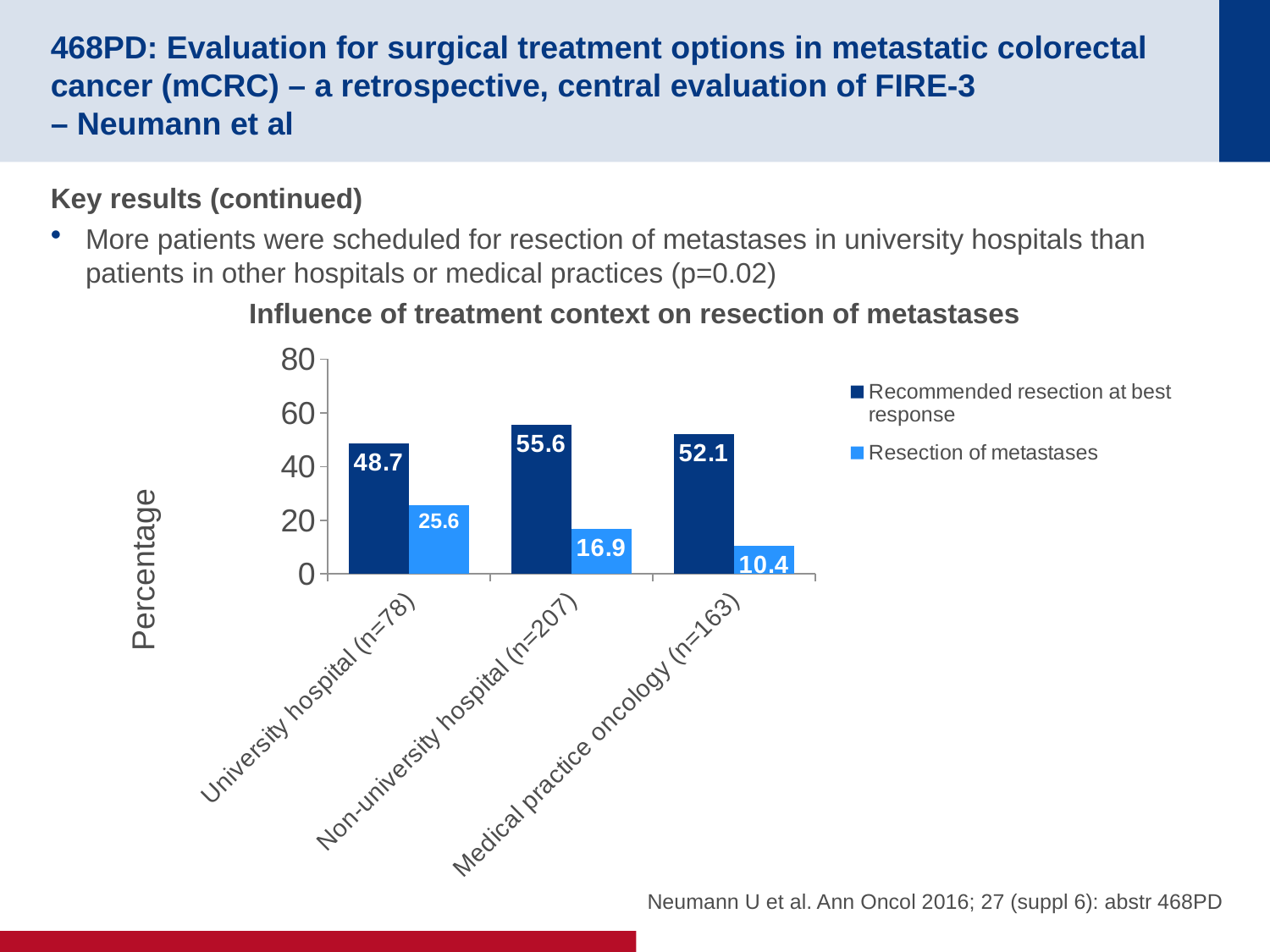
What is the value for 'Resection of metastases' for Medical practice oncology (n=163)? 10.4 Which category has the highest value for 'Recommended resection at best response'? Non-university hospital (n=207) What is the value for 'Resection of metastases' for Non-university hospital (n=207)? 16.9 What is the title of the chart? Influence of treatment context on resection of metastases What is the difference between 'Recommended resection at best response' and 'Resection of metastases' for University hospital (n=78)? 23.1 Which category has the lowest value for 'Resection of metastases'? Medical practice oncology (n=163) What is the value for 'Recommended resection at best response' for University hospital (n=78)? 48.7 What kind of chart is shown? Bar chart How many series does the legend list? 2 Which is larger: 'Resection of metastases' for University hospital (n=78) or for Non-university hospital (n=207)? University hospital (n=78) Is the value for 'Recommended resection at best response' for Medical practice oncology (n=163) greater or less than 40? greater How many categories are shown on the x axis? 3